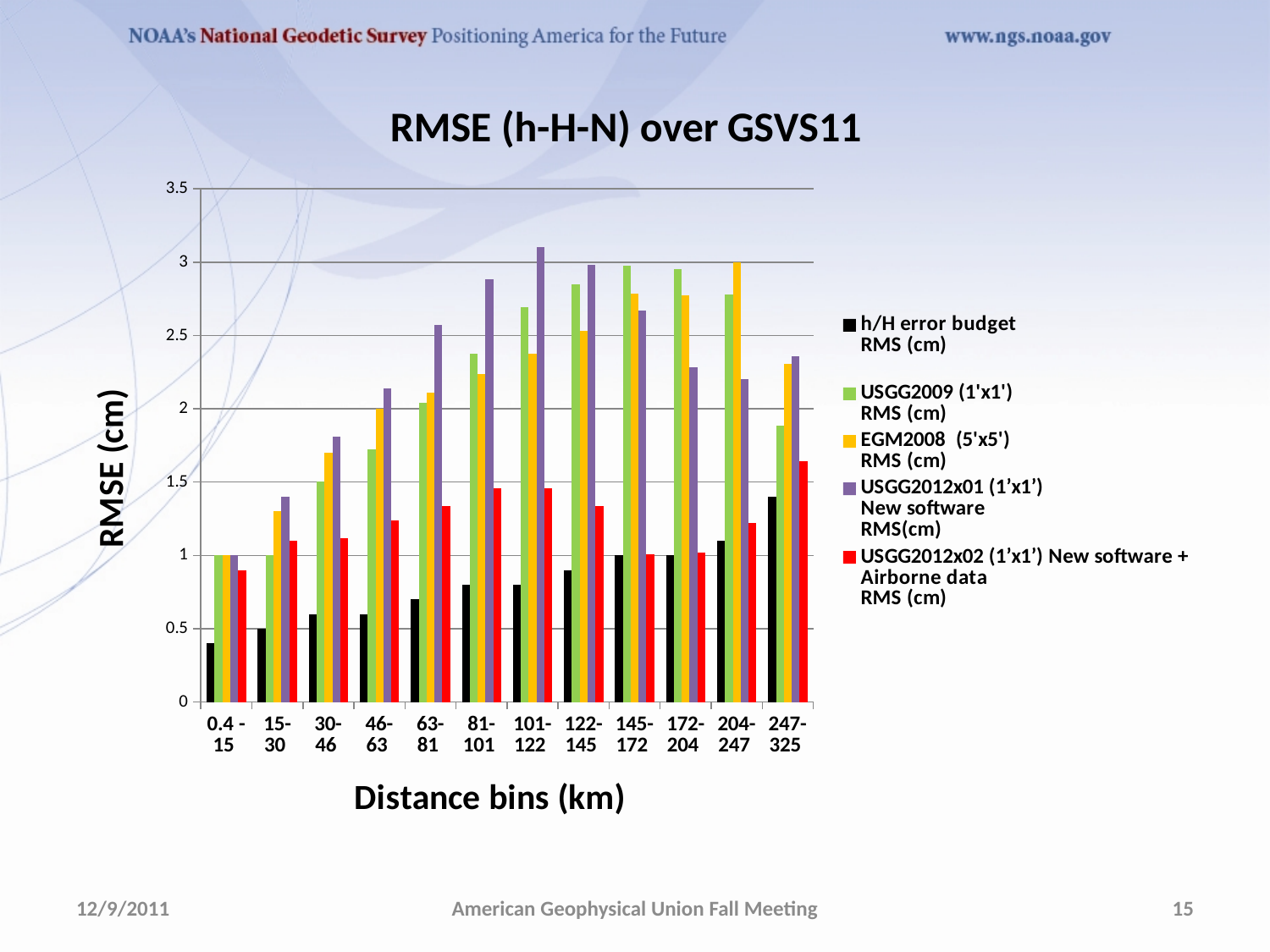
How many distance bins are shown on the x axis? 12 What is the title of the chart? RMSE (h-H-N) over GSVS11 Which distance bin has the highest USGG2012x01 (1'x1') New software value? 101-122 Is the USGG2012x01 (1'x1') New software value for the 101-122 km bin greater or less than 3? greater Which distance bin has the lowest h/H error budget value? 0.4 - 15 In the 247-325 km bin, which is larger: the USGG2012x02 (1'x1') New software + Airborne data value or the h/H error budget value? USGG2012x02 (1'x1') New software + Airborne data How many series does the legend list? 5 Is the USGG2009 (1'x1') value for the 145-172 km bin greater or less than 2.5? greater Is the h/H error budget value for the 0.4-15 km bin greater or less than 0.5? less In the 63-81 km bin, which is larger: the USGG2012x01 (1'x1') New software value or the EGM2008 (5'x5') value? USGG2012x01 (1'x1') New software What kind of chart is shown on the slide? bar chart What is the label of the y axis? RMSE (cm)